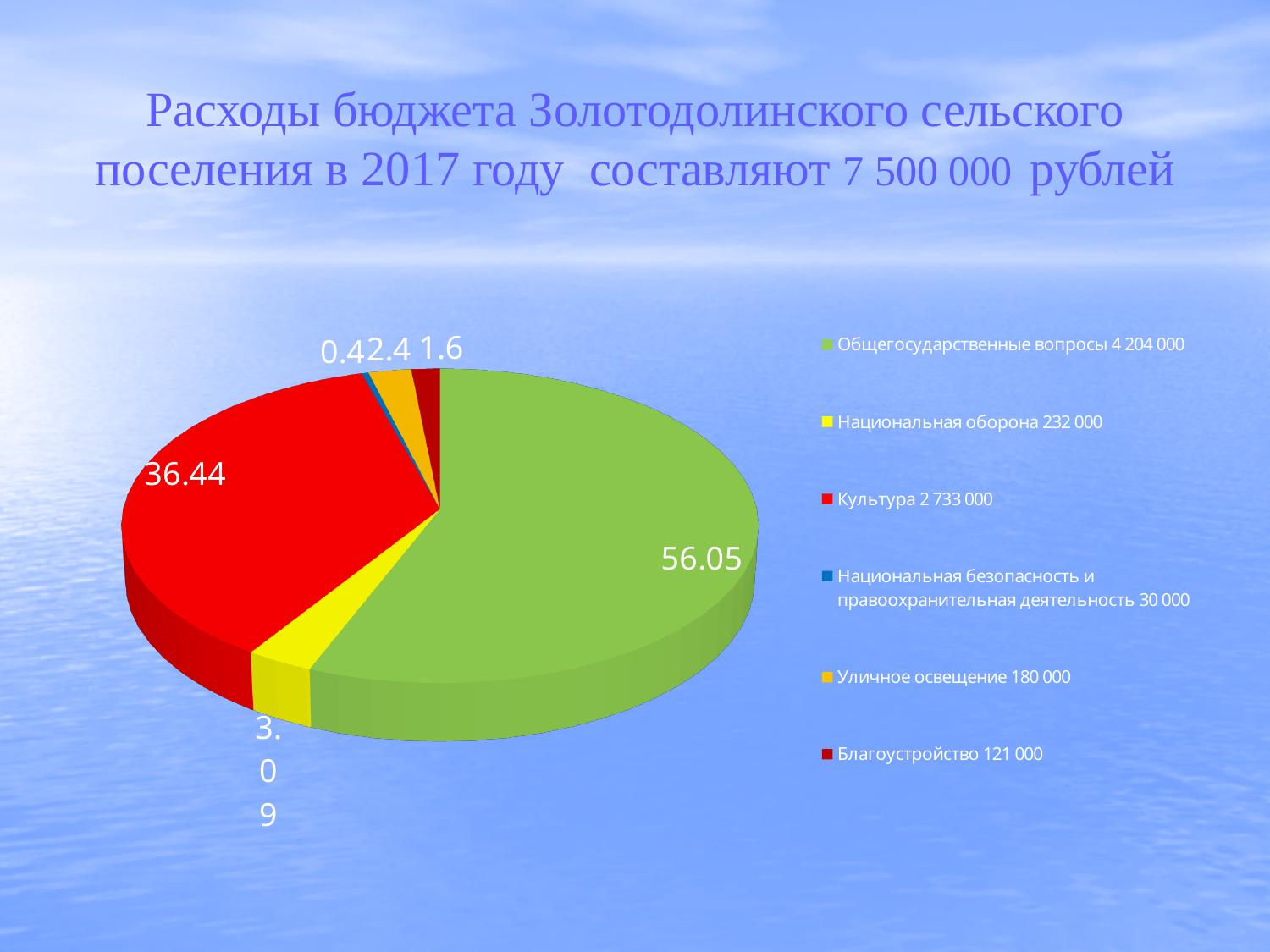
Which category has the smallest slice of the pie? Национальная безопасность и правоохранительная деятельность Which category has the largest slice of the pie? Общегосударственные вопросы What percentage label is shown on the red slice (Культура)? 36.44 According to the legend, what is the amount for Культура? 2 733 000 According to the legend, what is the amount for Национальная безопасность и правоохранительная деятельность? 30 000 What is the difference in percentage points between the Общегосударственные вопросы slice (56.05) and the Культура slice (36.44)? 19.61 What percentage label is shown on the green slice (Общегосударственные вопросы)? 56.05 What type of chart is shown on the slide? pie chart How many categories does the legend list? 6 What percentage label is shown on the yellow slice (Национальная оборона)? 3.09 Which is larger: the amount for Национальная оборона or the amount for Благоустройство? Национальная оборона According to the legend, what is the amount for Уличное освещение? 180 000